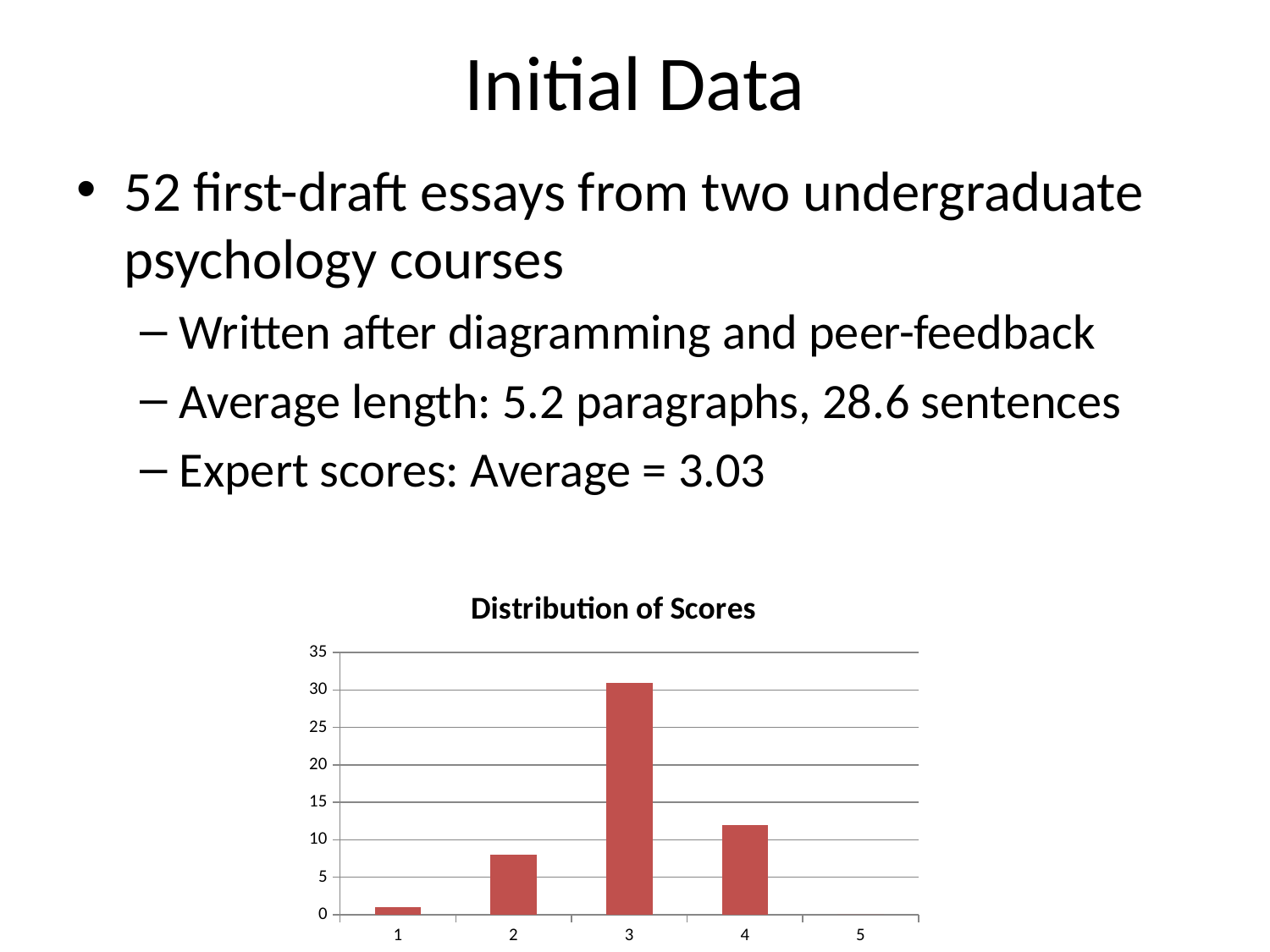
Is the value for score 4 greater or less than 10? greater What colour are the bars in the chart? red Which has the larger value, score 1 or score 2? 2 Is the value for score 3 greater or less than 25? greater Which score category has the lowest value in the chart? 5 Which score category has the highest bar in the chart? 3 Is the value for score 2 greater or less than 10? less What type of chart is shown on the slide? bar chart What is the title of the chart? Distribution of Scores Which has the larger value, score 2 or score 4? 4 How many score categories are shown on the x axis of the chart? 5